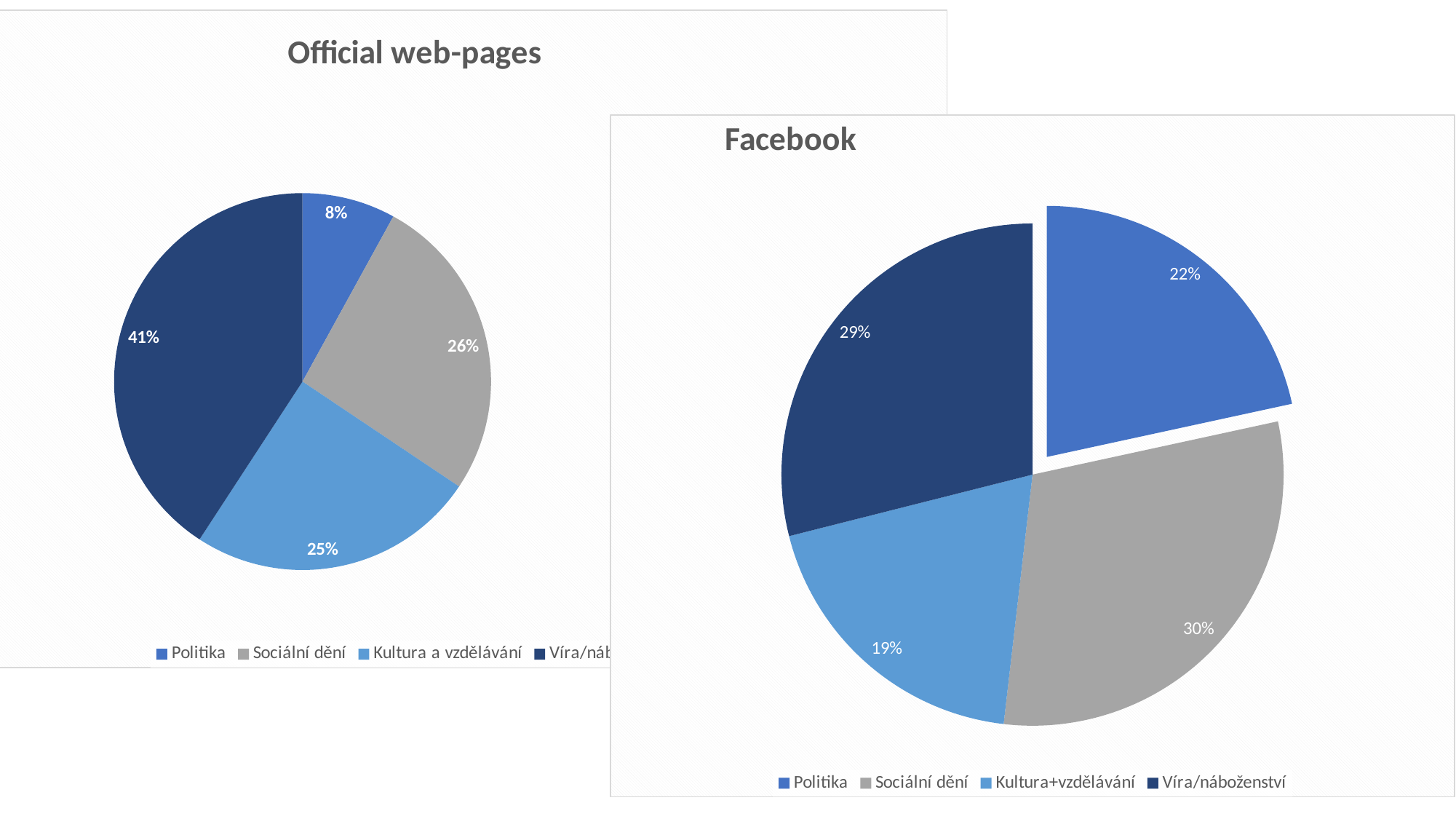
In the Facebook chart, which category has the smallest share? Kultura+vzdělávání In the Facebook chart, what share does Kultura+vzdělávání have? 19% In the Official web-pages chart, what share does Sociální dění have? 26% In the Official web-pages chart, which category has the largest share? Víra/náboženství In the Facebook chart, which category has the largest share? Sociální dění What type of chart is the Facebook chart? Pie chart In the Official web-pages chart, which category has the smallest share? Politika In the Official web-pages chart, what share does Politika have? 8% In the Official web-pages chart, what share does Kultura a vzdělávání have? 25% In the Facebook chart, what share does Politika have? 22% In the Facebook chart, what is the difference between the shares of Sociální dění and Víra/náboženství? 1% How many categories does the legend of the Facebook chart list? 4